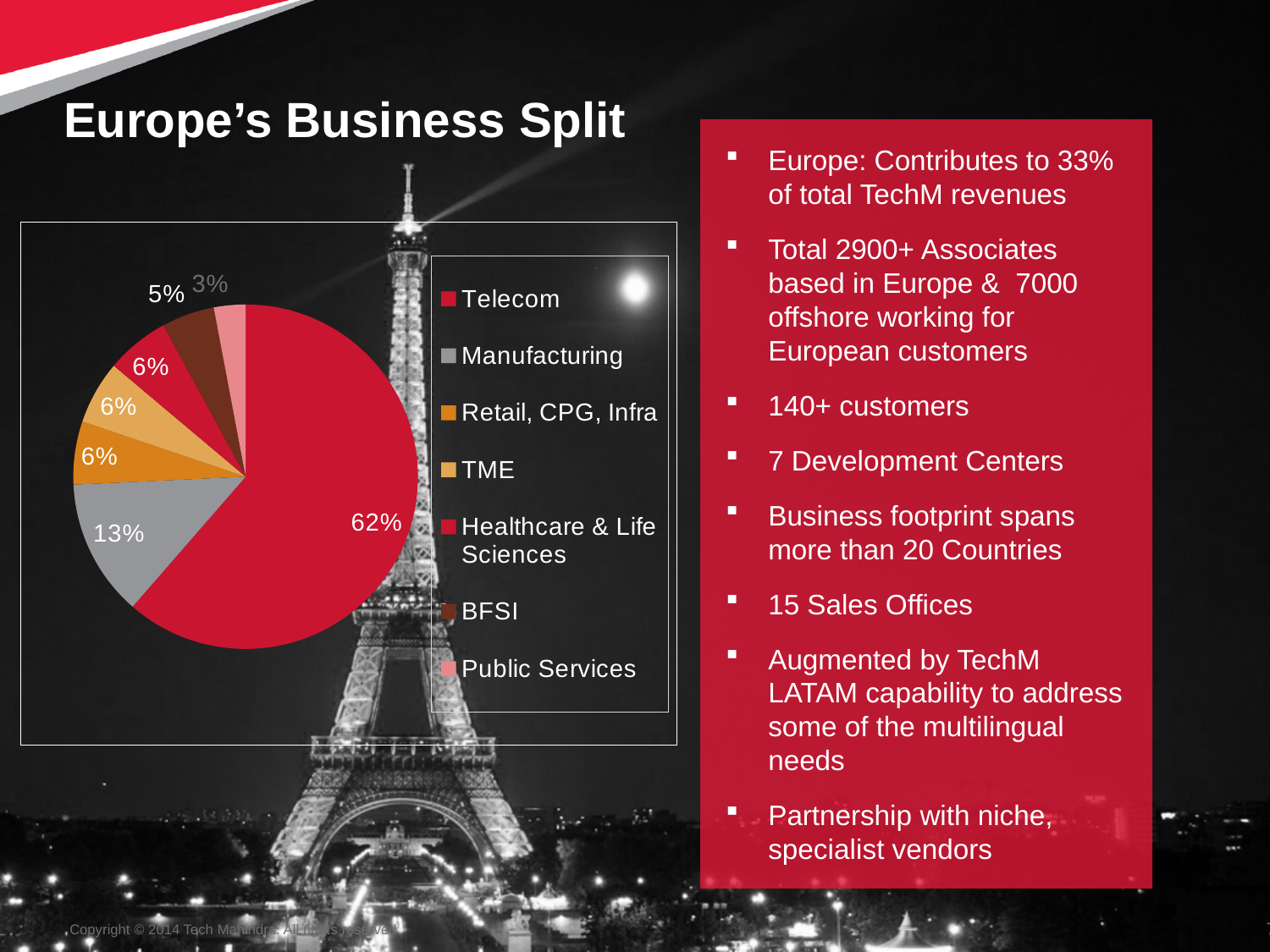
What is the value shown for BFSI in the pie chart? 5% How many categories are shown in the pie chart? 7 What is the title of the chart on the slide? Europe's Business Split What share of Europe's business does Telecom account for in the pie chart? 62% What is the difference in percentage points between Telecom and Manufacturing? 49% Which category has the smallest slice of the pie chart? Public Services What percentage does Manufacturing represent in the pie chart? 13% What percentage is shown for Public Services in the pie chart? 3% Which is larger in the pie chart, Manufacturing or BFSI? Manufacturing How many entries does the legend of the pie chart list? 7 What type of chart is used on the slide? Pie chart Which category has the largest slice of the pie chart? Telecom